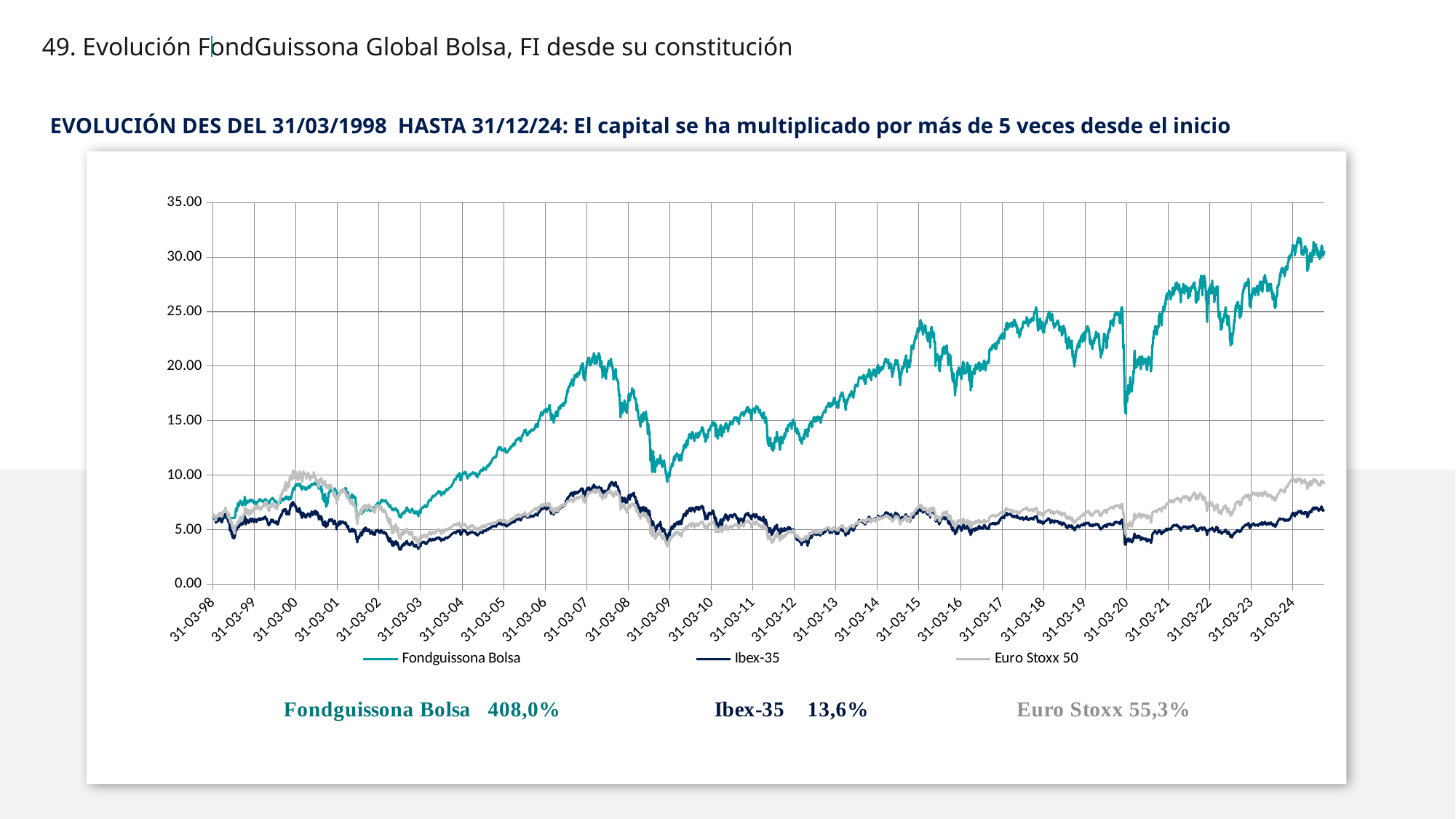
What cumulative return is printed for Ibex-35 below the chart? 13,6% Is the value of the Ibex-35 line at 31-03-24 greater or less than 10.00? less What cumulative return is printed for Euro Stoxx below the chart? 55,3% How many series does the chart legend list? 3 Does the Fondguissona Bolsa line rise or fall overall from 31-03-98 to the end of the chart? rise What is the difference between the printed returns of Euro Stoxx and Ibex-35? 41,7% Which series has the lowest cumulative return printed below the chart? Ibex-35 What kind of chart is shown on the slide? line chart Which series are listed in the chart legend? Fondguissona Bolsa, Ibex-35, Euro Stoxx 50 Which series has the highest cumulative return printed below the chart? Fondguissona Bolsa Is the value of the Fondguissona Bolsa line at 31-03-24 greater or less than 25.00? greater What cumulative return is printed for Fondguissona Bolsa below the chart? 408,0%